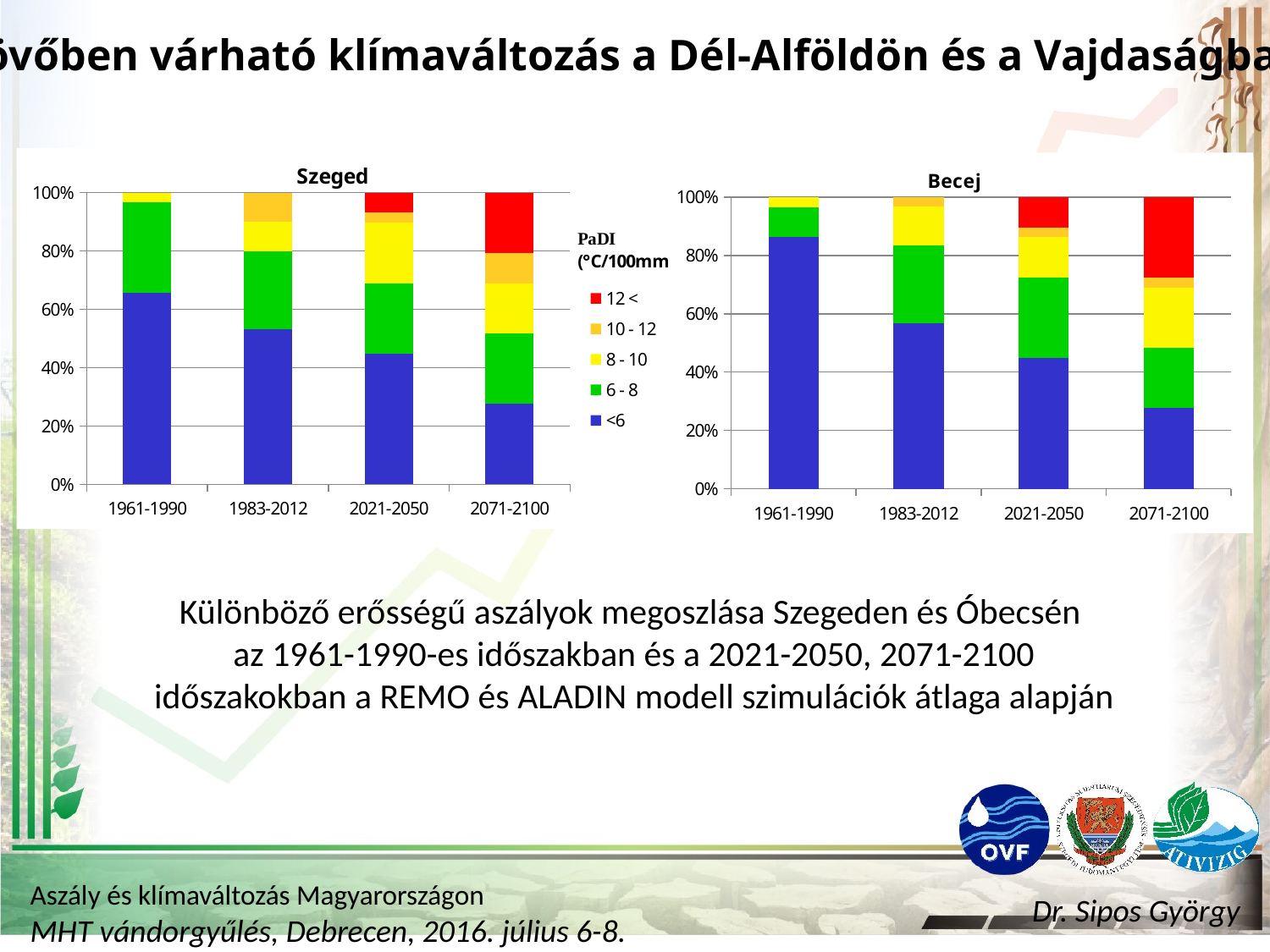
In the Szeged chart, does the share of the <6 category rise or fall from 1961-1990 to 2071-2100? fall In the Szeged chart, which period has the lowest share of the <6 category? 2071-2100 For the 1961-1990 period, is the share of the <6 category larger in the Szeged chart or the Becej chart? Becej In the Becej chart, which period has the highest share of the <6 category? 1961-1990 What is the total height of each stacked bar in the Becej chart? 100% How many series does the legend between the two charts list? 5 In the Szeged chart, is the share of the <6 category for 2071-2100 greater or less than 40%? less In the Becej chart, is the share of the <6 category for 1961-1990 greater or less than 80%? greater What is the title of the left chart? Szeged What kind of chart is the Szeged chart? stacked bar chart In the Szeged chart, is the share of the <6 category for 1961-1990 greater or less than 60%? greater How many time periods are shown on the x axis of the Becej chart? 4